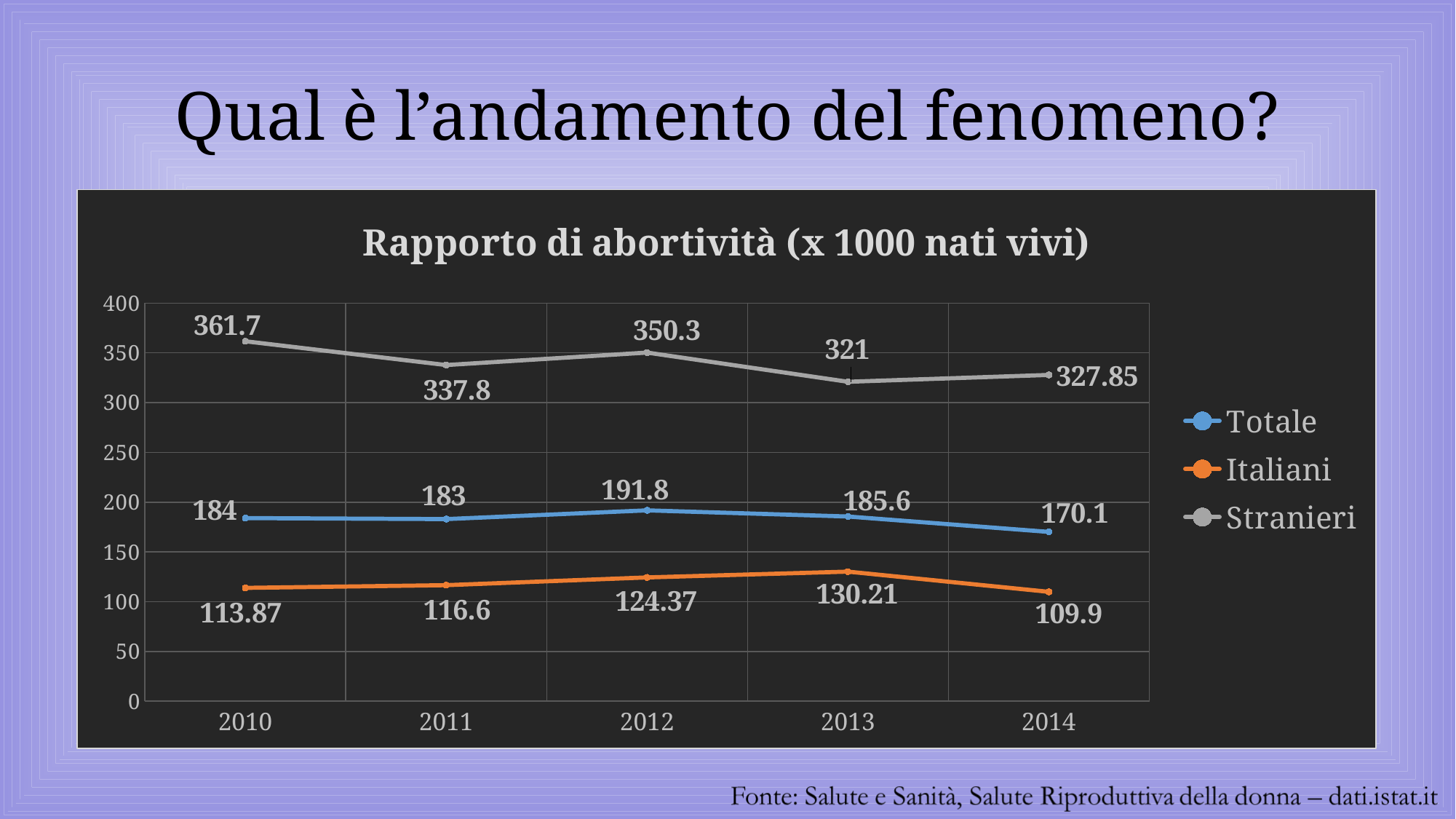
Is the value for Stranieri in 2013 greater or less than 350? less In which year is the Stranieri series lowest? 2013 Which is larger, the Italiani value in 2012 or in 2014? 2012 What kind of chart is shown? line chart How many series does the legend list? 3 What is the value for Totale in 2014? 170.1 In which year is the Totale series highest? 2012 What is the value for Italiani in 2013? 130.21 What is the difference between the Stranieri values in 2010 and 2014? 33.85 How many years are shown on the x axis? 5 What is the title of the chart? Rapporto di abortività (x 1000 nati vivi) What is the value for Stranieri in 2010? 361.7